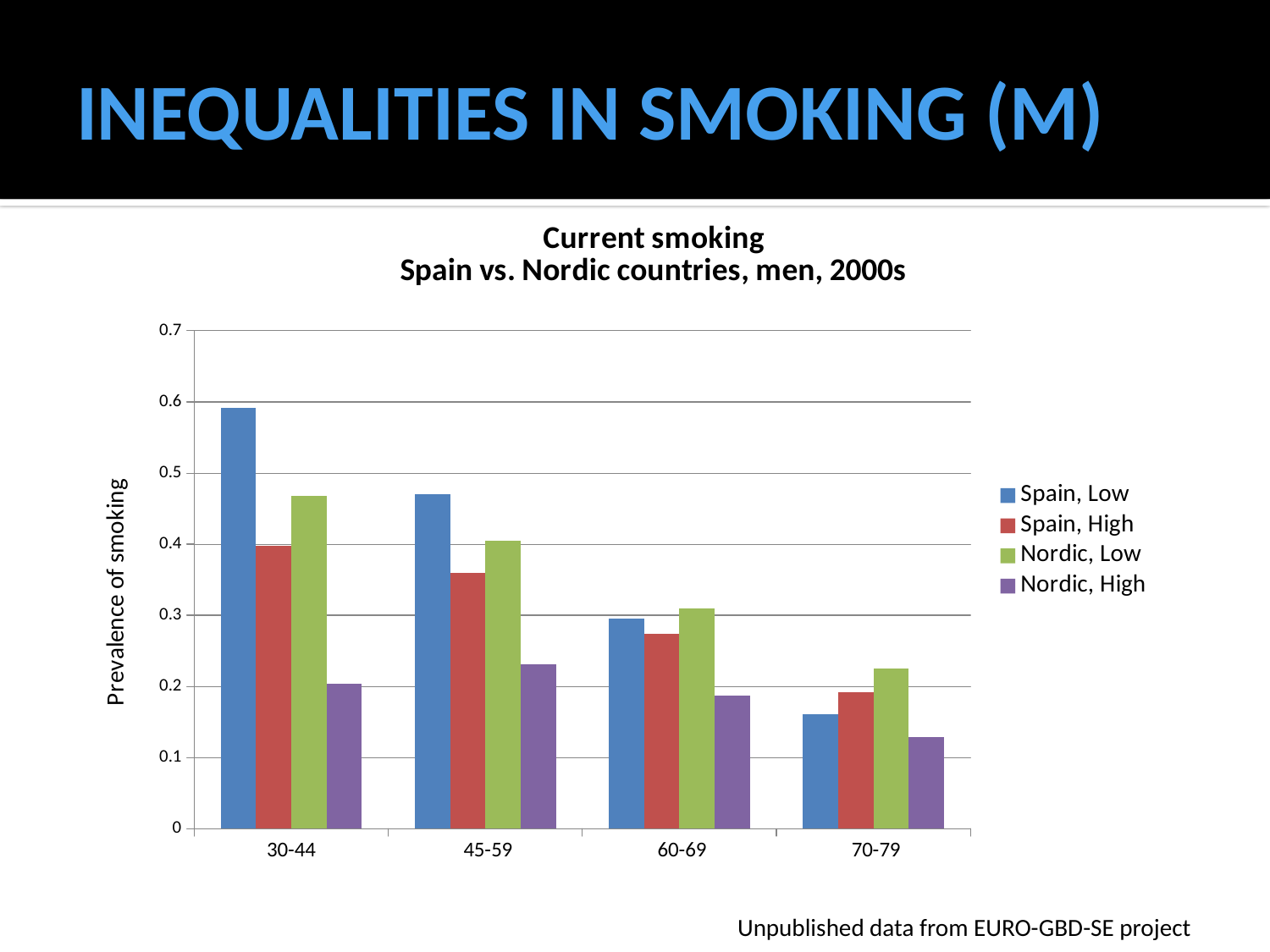
Which series has the lowest value in the 70-79 age group? Nordic, High Is the value for Spain, Low in the 30-44 age group greater or less than 0.5? greater Which age group has the highest bar for Spain, Low? 30-44 How many age groups are shown on the x axis? 4 Is the value for Nordic, High in the 70-79 age group greater or less than 0.2? less In the 30-44 age group, which is larger: Spain, Low or Nordic, Low? Spain, Low What kind of chart is shown on the slide? Bar chart How many series does the legend list? 4 Do the values for Spain, Low rise or fall as age group increases along the x axis? fall What is the label of the vertical axis? Prevalence of smoking Is the value for Spain, High in the 45-59 age group greater or less than 0.3? greater